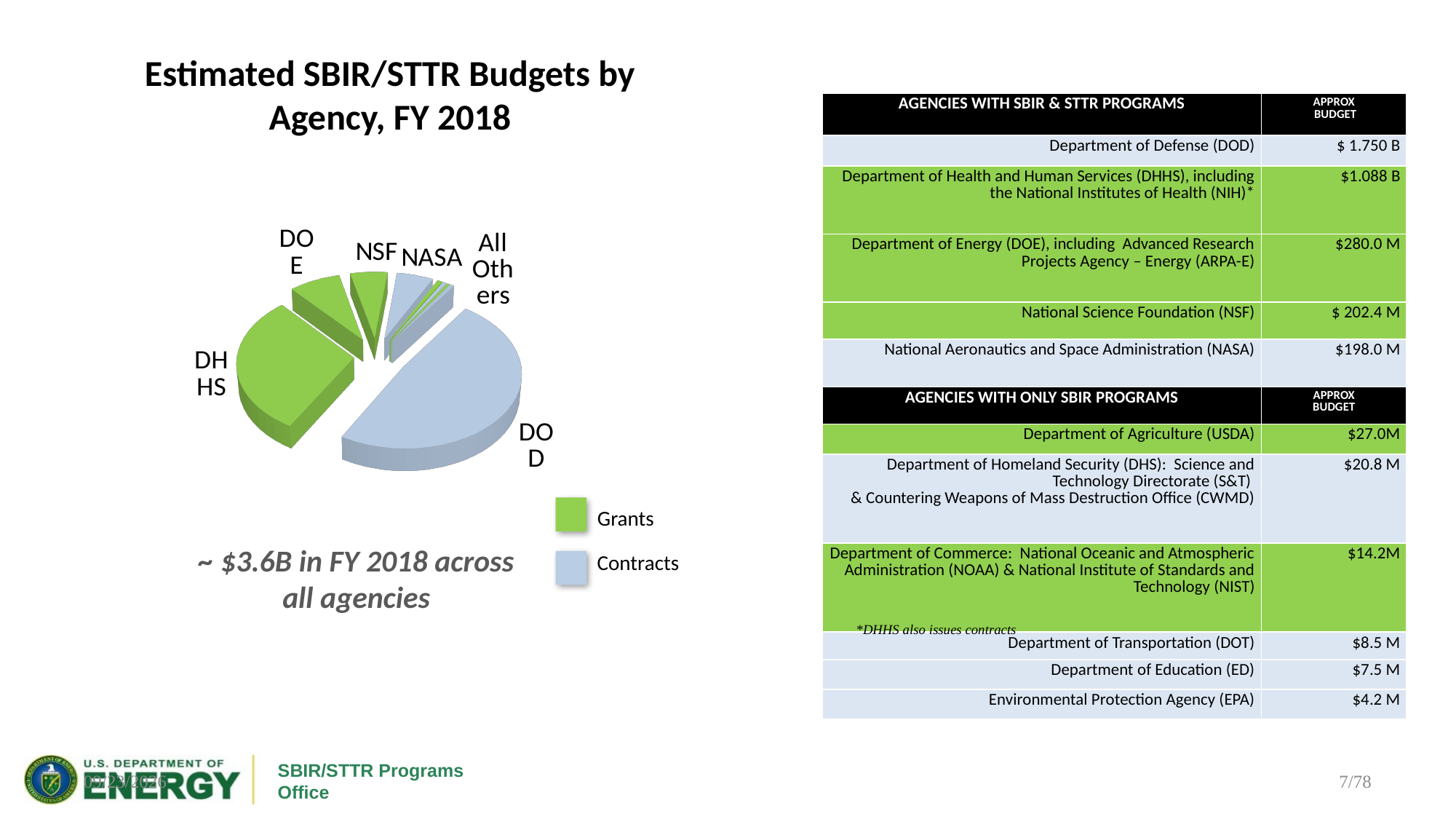
In the pie chart, which slice is larger, DHHS or DOE? DHHS What kind of chart is shown on the left of the slide? pie chart In the pie chart, which slice is larger, DOE or NSF? DOE Which labeled category has the smallest slice in the pie chart? All Others In the pie chart, which slice is larger, DOD or DHHS? DOD How many labeled categories does the pie chart show? 6 Which legend entry does the green colour in the pie chart represent? Grants How many entries does the pie chart's legend list? 2 Which agency has the second-largest slice in the pie chart? DHHS Which agency has the largest slice in the pie chart? DOD What is the title of the chart on the slide? Estimated SBIR/STTR Budgets by Agency, FY 2018